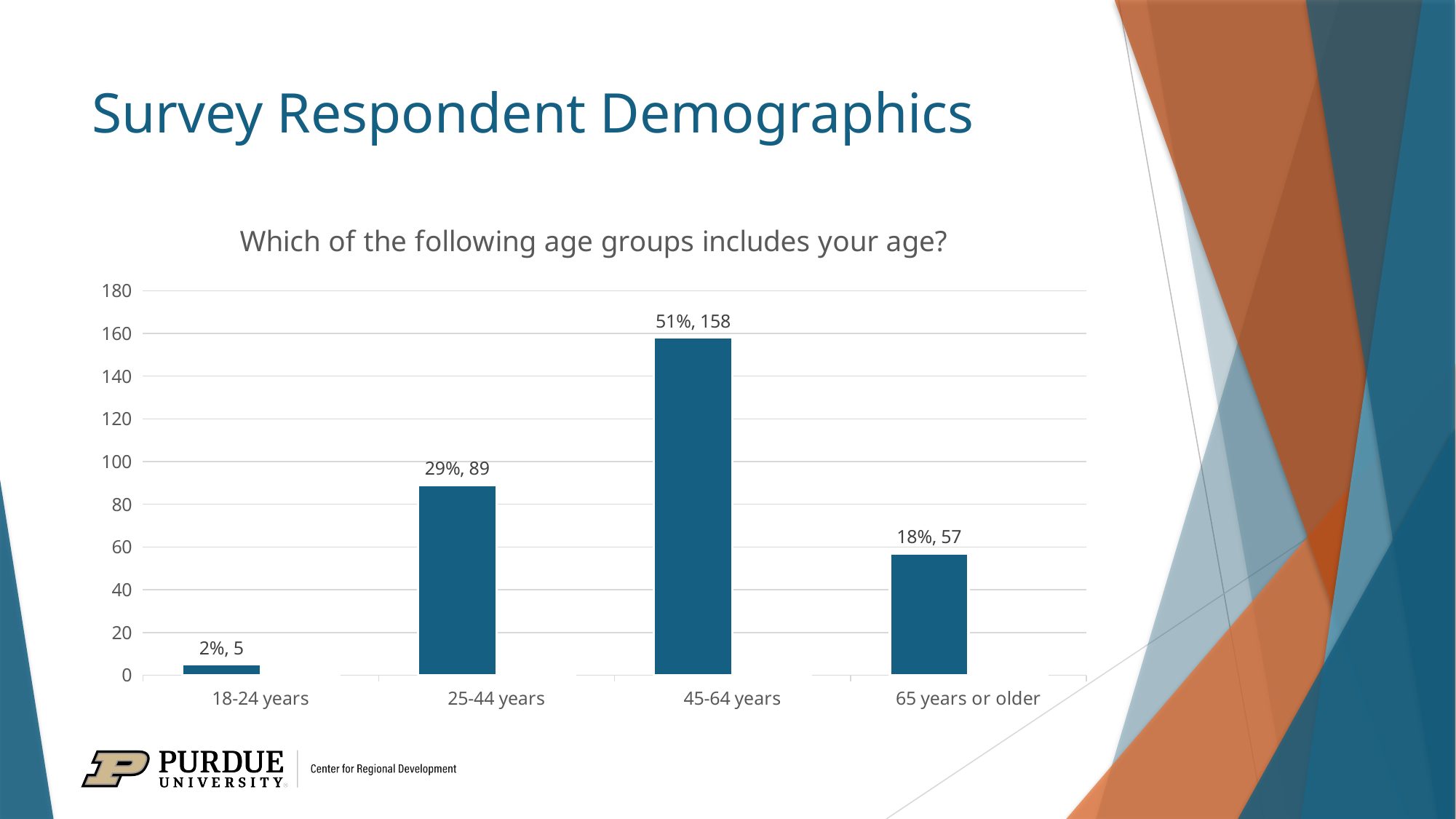
What is the data label shown for the 65 years or older bar? 18%, 57 What is the title of the chart? Which of the following age groups includes your age? What is the maximum value shown on the vertical axis? 180 Is the value for 65 years or older greater or less than 60? less How many respondents are in the 45-64 years age group? 158 Which age group has the highest number of respondents? 45-64 years Which group has more respondents, 25-44 years or 65 years or older? 25-44 years How many age group categories are shown on the chart? 4 Which age group has the lowest number of respondents? 18-24 years What is the difference in respondent count between the 45-64 years and 25-44 years groups? 69 What kind of chart is shown on the slide? Bar chart What percentage of respondents are in the 25-44 years age group? 29%